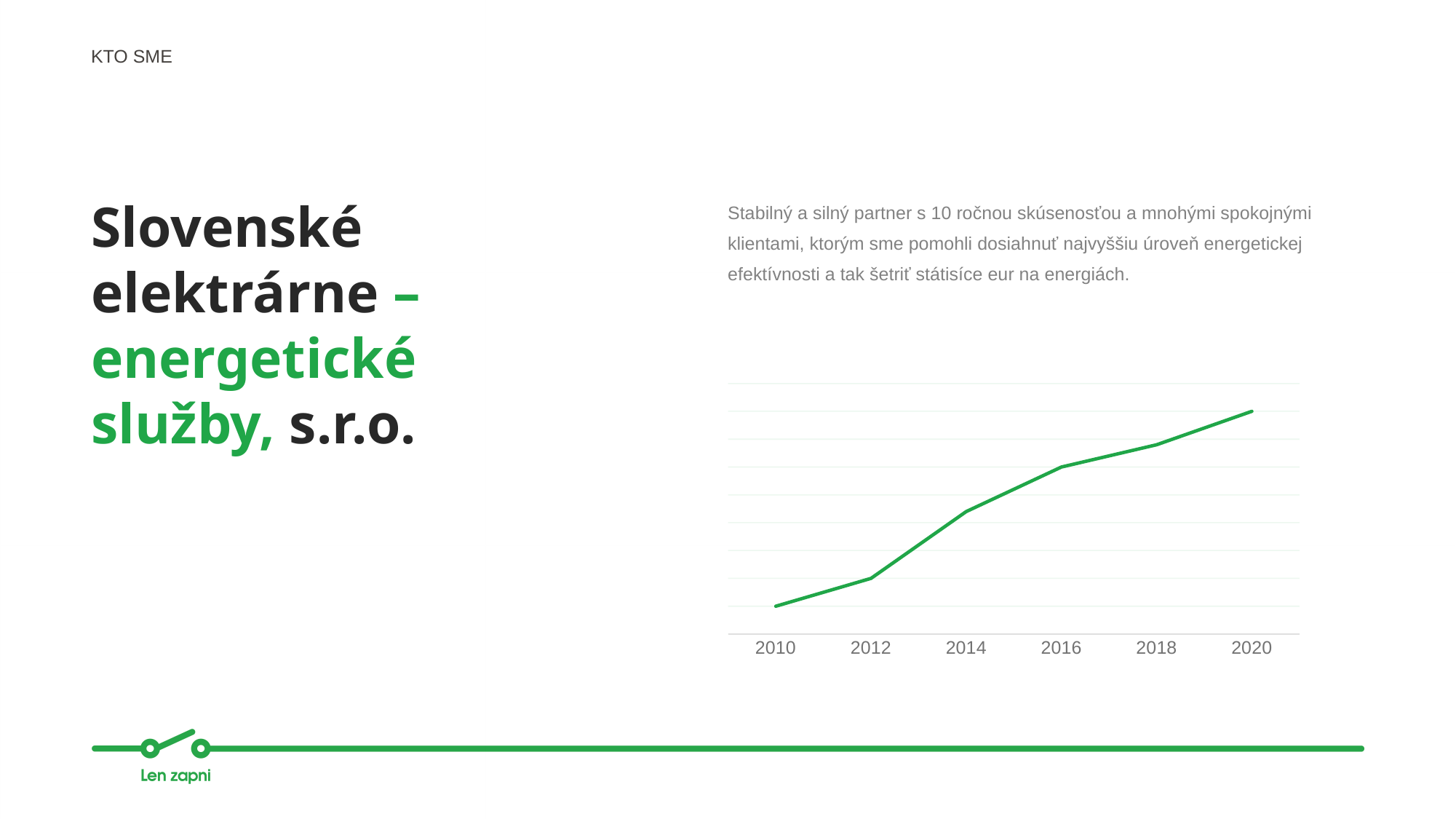
Is the value for 2014 greater or less than the value for 2012? greater What is the first year shown on the x axis of the chart? 2010 Which year has the larger value on the chart, 2012 or 2016? 2016 What is the last year shown on the x axis of the chart? 2020 Do the values on the chart rise or fall from 2010 to 2020? rise Which year on the chart has the highest value? 2020 How many year labels are shown on the x axis of the chart? 6 What kind of chart is shown on the slide? line chart Which year on the chart has the lowest value? 2010 Which year has the larger value on the chart, 2018 or 2014? 2018